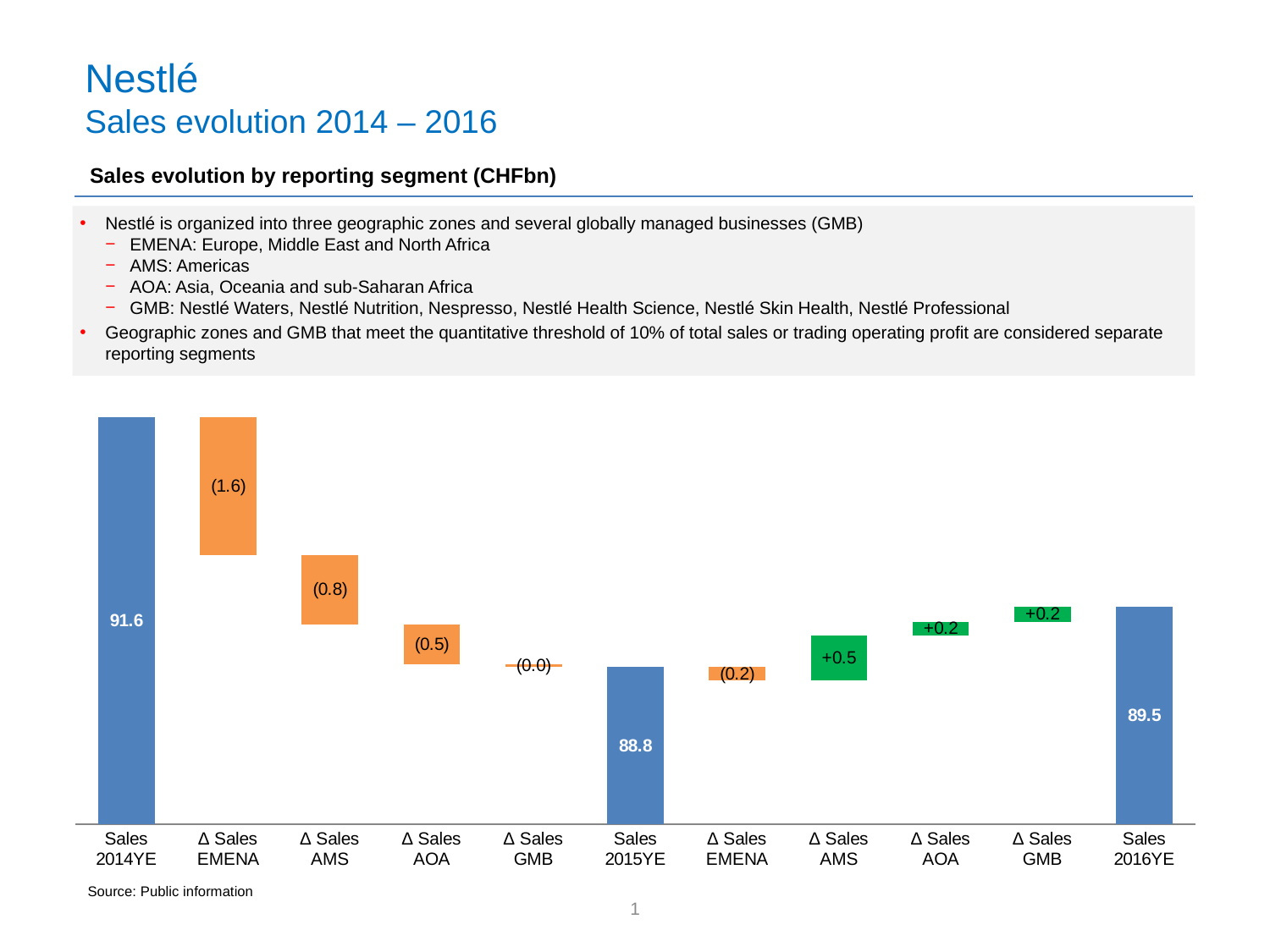
What is the value of Sales 2016YE? 89.5 Which of the three year-end sales bars (2014YE, 2015YE, 2016YE) is the lowest? Sales 2015YE Is Sales 2016YE larger or smaller than Sales 2015YE? larger What is the Δ Sales EMENA value between Sales 2014YE and Sales 2015YE? (1.6) What is the Δ Sales GMB value between Sales 2014YE and Sales 2015YE? (0.0) What is the value of Sales 2015YE? 88.8 How many categories are shown on the x axis of the chart? 11 What is the Δ Sales AMS value between Sales 2015YE and Sales 2016YE? +0.5 Which of the three year-end sales bars (2014YE, 2015YE, 2016YE) is the highest? Sales 2014YE What is the value of Sales 2014YE? 91.6 What is the difference between Sales 2014YE and Sales 2015YE? 2.8 What kind of chart is shown on the slide? Bar chart (waterfall)